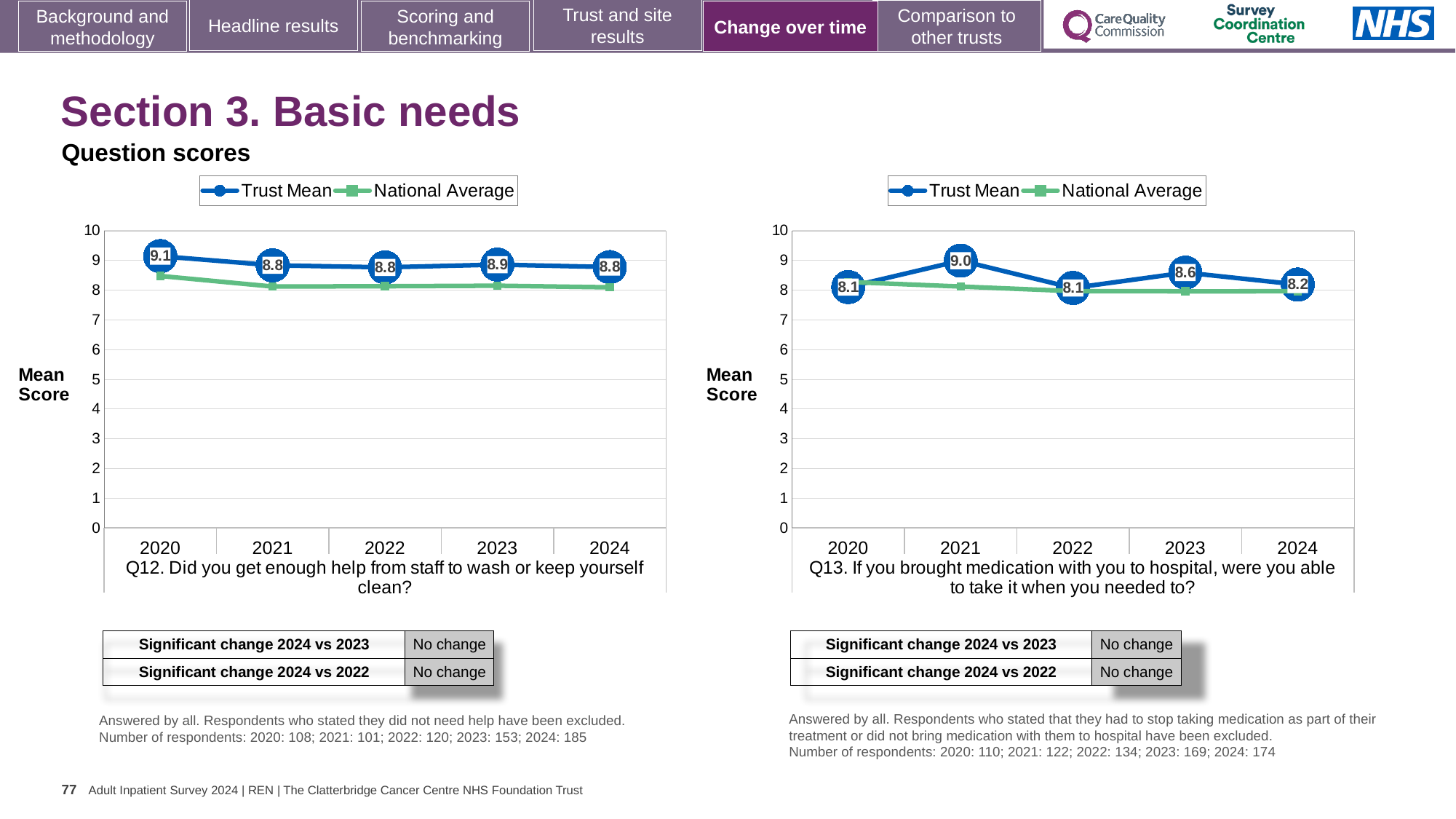
On the Q13 chart (right), what is the Trust Mean for 2021? 9.0 On the Q13 chart (right), is the National Average for 2024 greater or less than 9? less How many series does the legend of the Q12 chart (left) list? 2 On the Q12 chart (left), what is the Trust Mean for 2023? 8.9 On the Q13 chart (right), which year has the highest Trust Mean? 2021 On the Q12 chart (left), how many years are plotted on the x axis? 5 On the Q13 chart (right), is the Trust Mean for 2023 larger or smaller than the Trust Mean for 2022? larger On the Q13 chart (right), what is the Trust Mean for 2024? 8.2 On the Q12 chart (left), which year has the highest Trust Mean? 2020 On the Q13 chart (right), what is the difference between the Trust Mean in 2021 and in 2022? 0.9 On the Q12 chart (left), what is the Trust Mean for 2020? 9.1 On the Q12 chart (left), what is the difference between the Trust Mean in 2020 and in 2024? 0.3